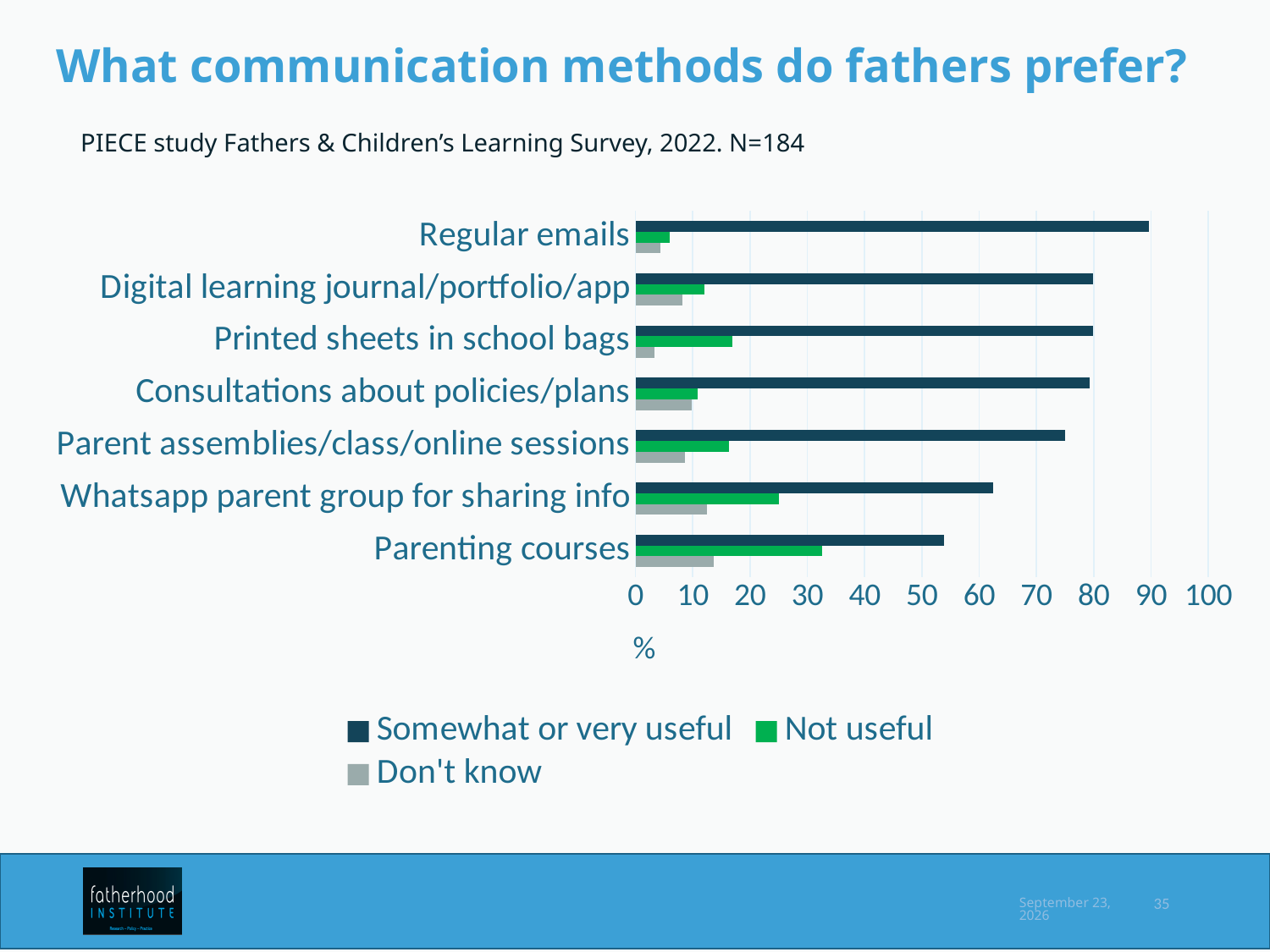
Is the 'Somewhat or very useful' value for Regular emails greater or less than 80? greater Do the 'Somewhat or very useful' values rise or fall going down the list from Regular emails to Parenting courses? fall Which has a larger 'Somewhat or very useful' value: Parent assemblies/class/online sessions or Whatsapp parent group for sharing info? Parent assemblies/class/online sessions Which communication method has the highest 'Not useful' value? Parenting courses What label is shown on the horizontal axis of the chart? % Which communication method has the lowest 'Somewhat or very useful' value? Parenting courses Is the 'Not useful' value for Whatsapp parent group for sharing info greater or less than 20? greater Is the 'Somewhat or very useful' value for Parenting courses greater or less than 60? less Which communication method has the highest 'Somewhat or very useful' value? Regular emails What kind of chart is shown on the slide? bar chart How many communication methods are listed on the chart? 7 How many series does the legend list? 3